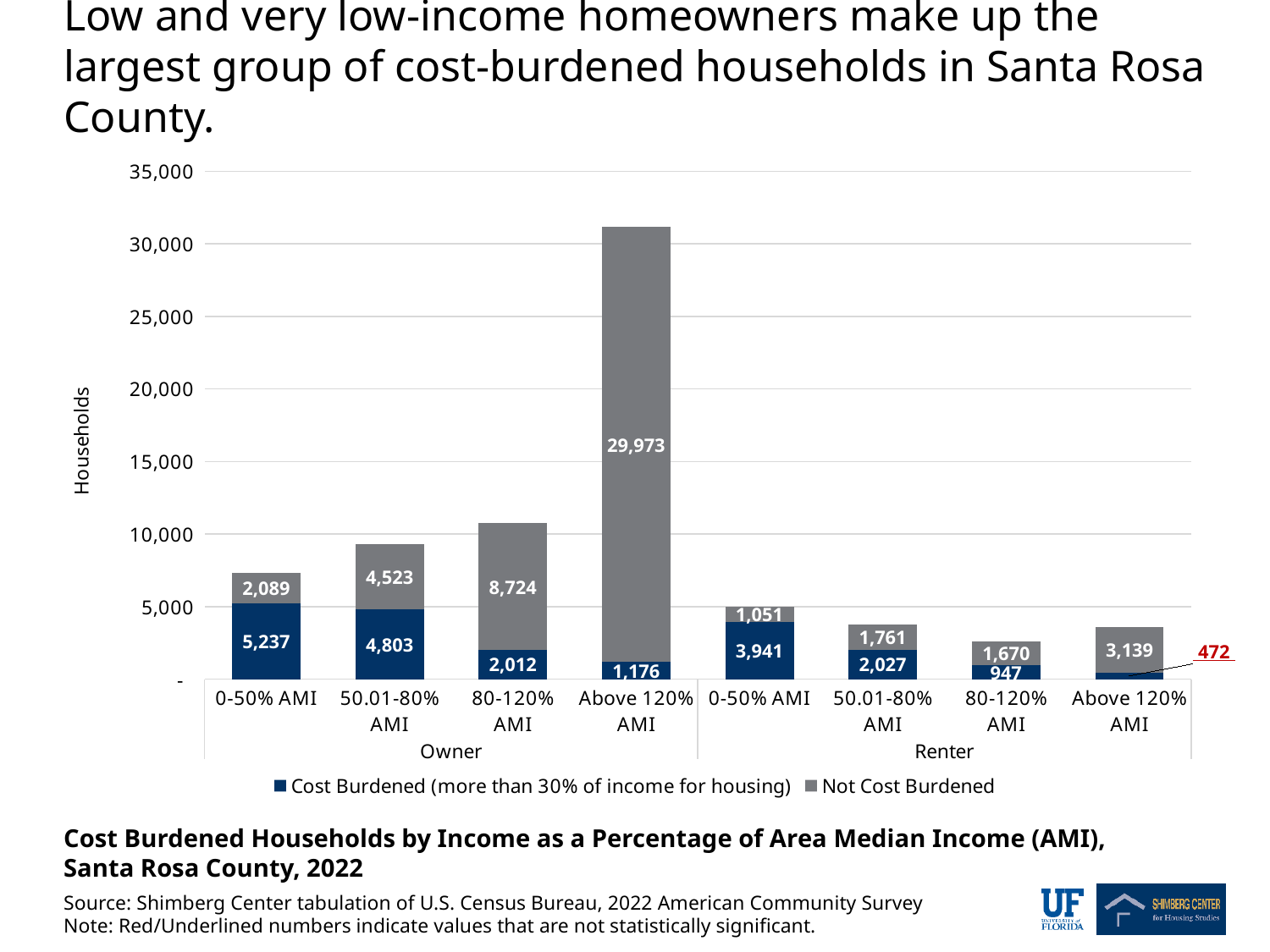
How many series does the legend list? 2 What is the number of cost-burdened owner households in the 0-50% AMI group? 5,237 What kind of chart is shown on the slide? Stacked bar chart What is the total number of renter households in the 0-50% AMI group (cost burdened plus not cost burdened)? 4,992 What is the number of cost-burdened renter households in the 80-120% AMI group? 947 What is the difference between cost-burdened owner households in the 0-50% AMI group and cost-burdened renter households in the 0-50% AMI group? 1,296 Which value on the chart is marked in red and underlined as not statistically significant? 472 Which is larger: the number of not cost-burdened owner households in the 50.01-80% AMI group or in the 80-120% AMI group? 80-120% AMI What is the number of not cost-burdened owner households in the Above 120% AMI group? 29,973 What is the total number of owner households in the Above 120% AMI group (cost burdened plus not cost burdened)? 31,149 Which group has the highest number of cost-burdened households? Owner 0-50% AMI Which group has the lowest number of cost-burdened households? Renter Above 120% AMI